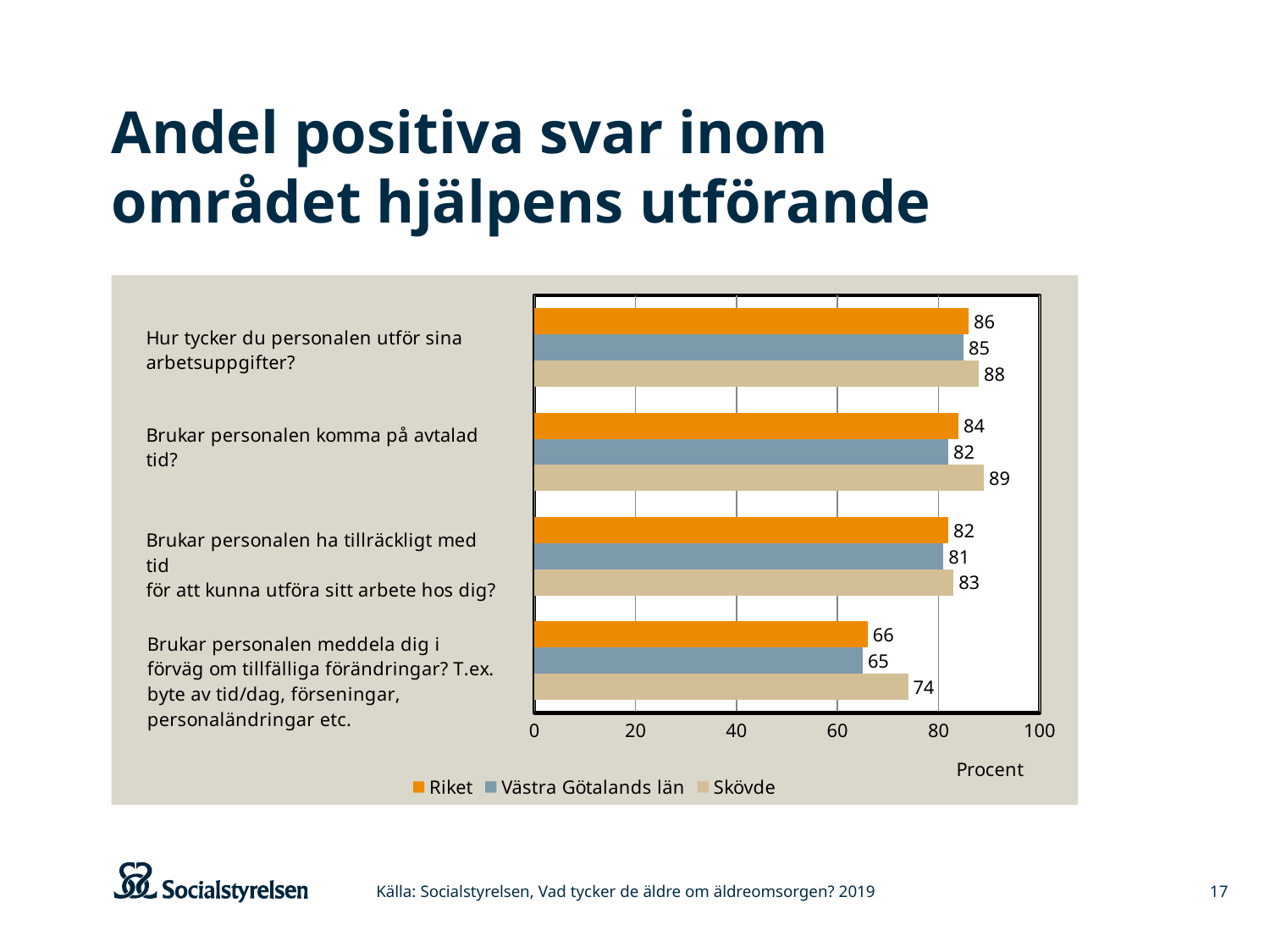
How many series does the legend list? 3 What is the value for Riket on "Brukar personalen meddela dig i förväg om tillfälliga förändringar?"? 66 What is the difference between Skövde and Västra Götalands län on "Brukar personalen meddela dig i förväg om tillfälliga förändringar?"? 9 Is the value for Riket on "Brukar personalen meddela dig i förväg om tillfälliga förändringar?" greater or less than 80? less What is the value for Västra Götalands län on "Hur tycker du personalen utför sina arbetsuppgifter?"? 85 Which series has the highest value on "Brukar personalen komma på avtalad tid?"? Skövde How many questions (categories) are shown in the chart? 4 What kind of chart is shown on the slide? bar chart What unit is shown on the horizontal axis? Procent Which is larger on "Brukar personalen ha tillräckligt med tid för att kunna utföra sitt arbete hos dig?": Riket or Skövde? Skövde What is the value for Skövde on "Brukar personalen komma på avtalad tid?"? 89 Which question has the lowest value for Skövde? Brukar personalen meddela dig i förväg om tillfälliga förändringar?